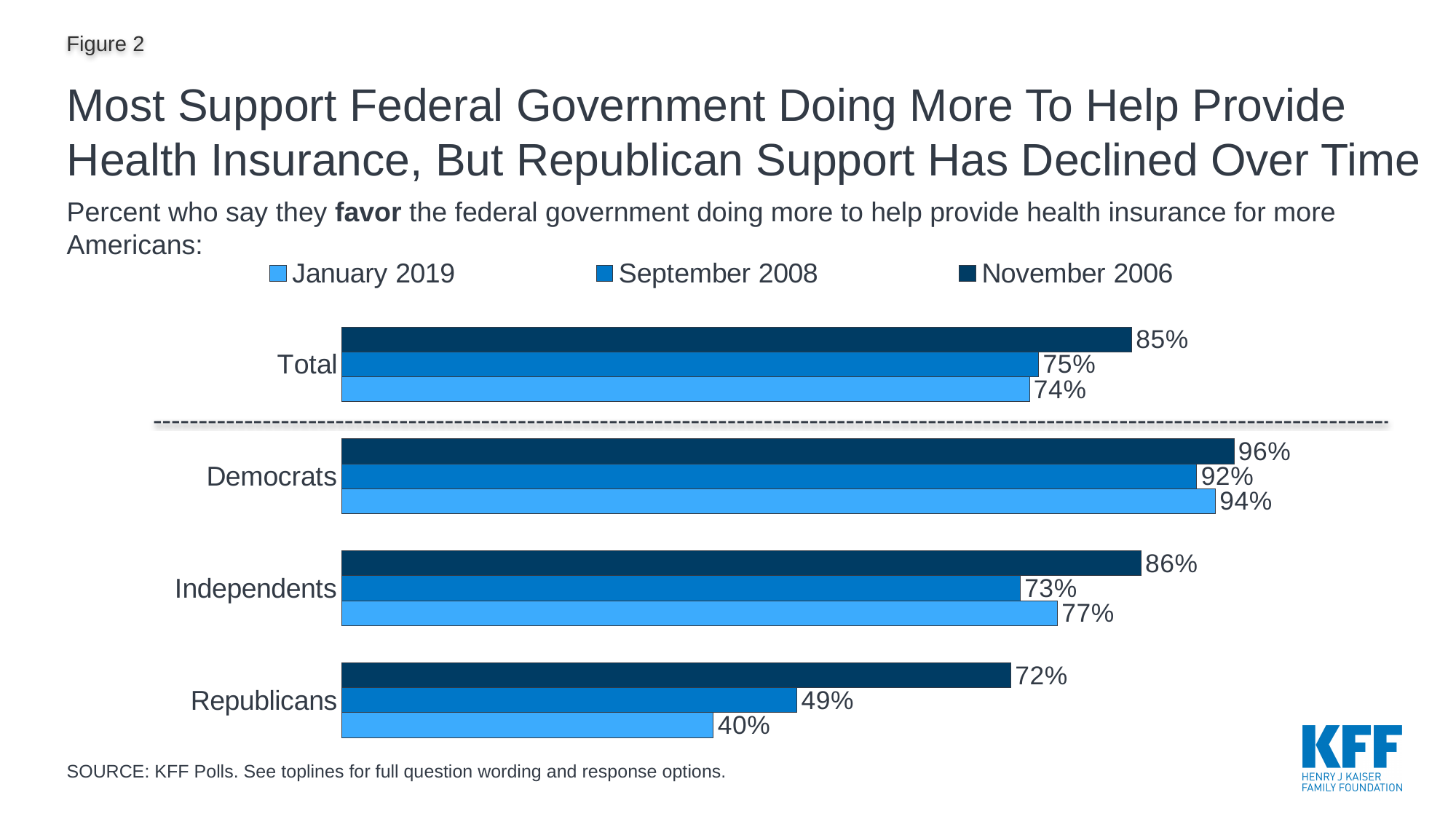
What kind of chart is shown on the slide? Bar chart How many series does the legend list? 3 Which survey date does the darkest blue bar represent? November 2006 By how many percentage points did Republican support fall from November 2006 to January 2019? 32 percentage points What percent of Independents favored the federal government doing more in September 2008? 73% Which group had the lowest value in November 2006? Republicans How many groups are shown on the chart? 4 Which is larger: the Independents value in January 2019 or the Independents value in September 2008? January 2019 What is the difference between Democrats and Republicans in September 2008? 43 percentage points Which group had the highest value in January 2019? Democrats What percent of Republicans favored the federal government doing more to help provide health insurance in January 2019? 40% What was the Total value in November 2006? 85%